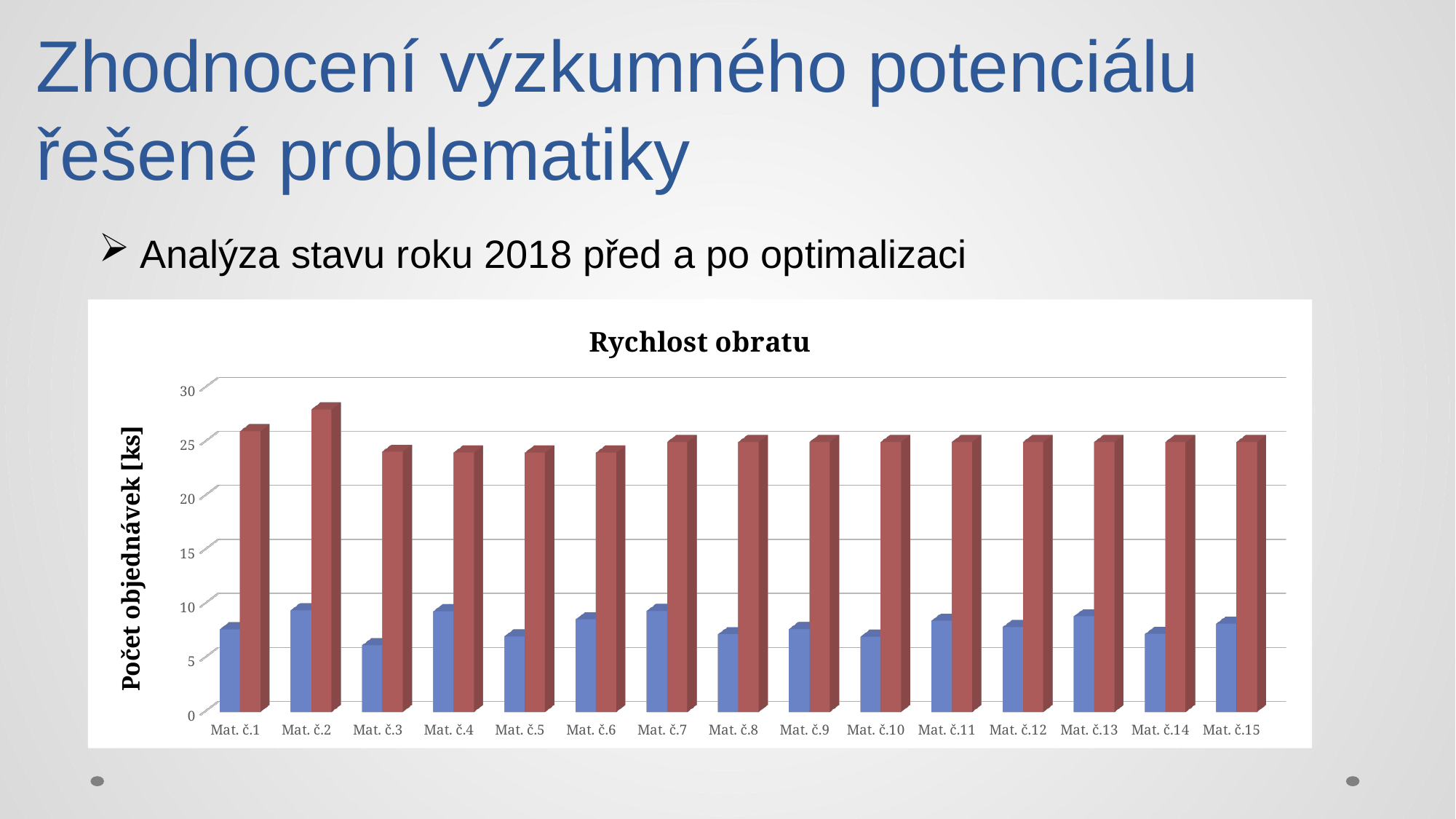
Which blue bar is larger, the one for Mat. č.2 or the one for Mat. č.3? Mat. č.2 What type of chart is shown on the slide? Bar chart What is the label of the vertical axis of the chart? Počet objednávek [ks] Is the blue bar for Mat. č.3 greater or less than 10? less For Mat. č.1, which bar is larger, the blue one or the red one? The red one Is the red bar for Mat. č.5 greater or less than 20? greater How many categories (materials) are shown on the x axis of the chart? 15 Is the red bar for Mat. č.2 greater or less than 30? less For which category is the blue bar the lowest? Mat. č.3 For which category is the red bar the highest? Mat. č.2 What is the title of the chart? Rychlost obratu